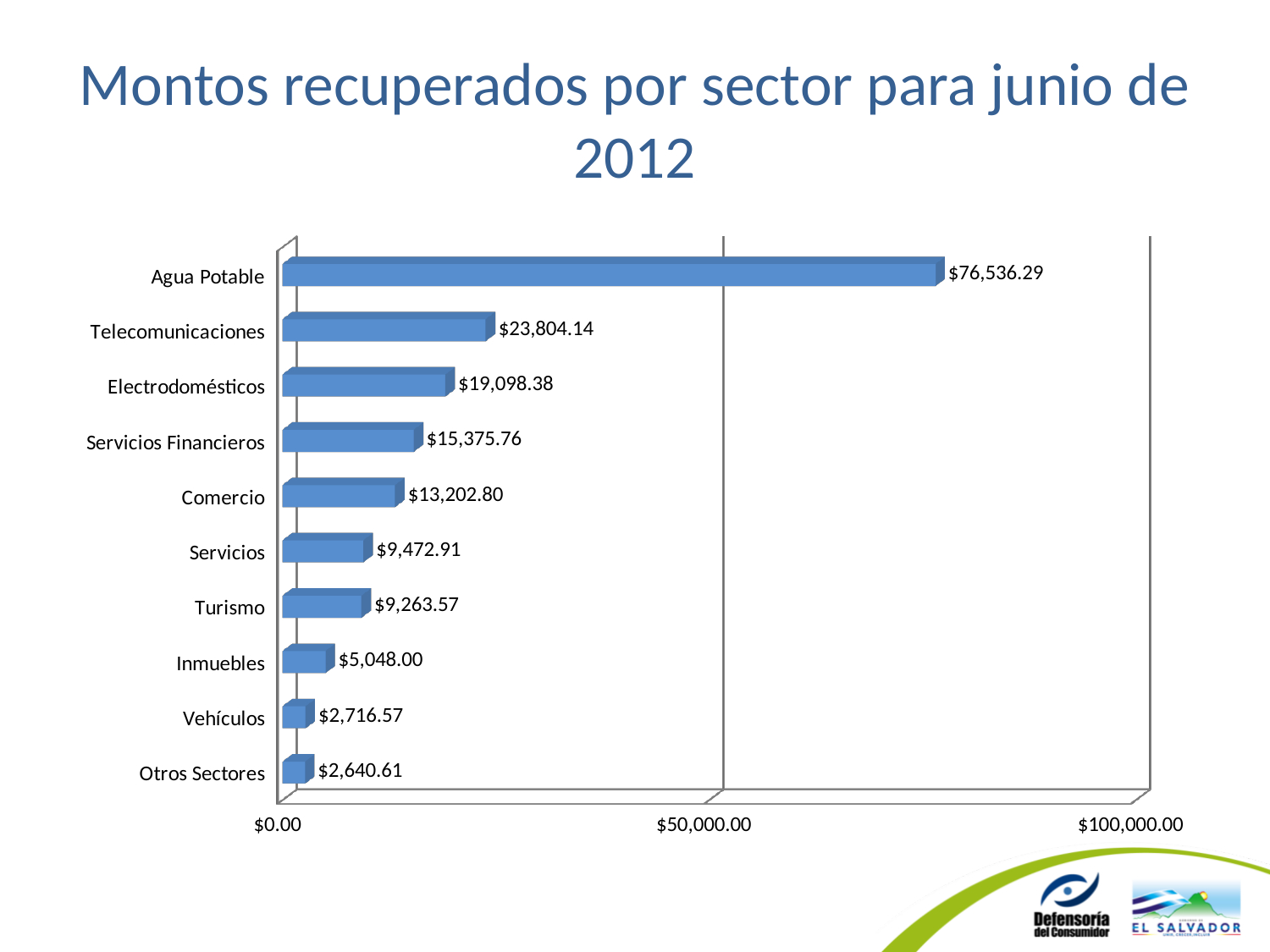
How many sectors are shown in the chart? 10 What is the value for Agua Potable? $76,536.29 What is the difference between the values for Agua Potable and Telecomunicaciones? $52,732.15 Which sector has the highest recovered amount? Agua Potable What is the value for Telecomunicaciones? $23,804.14 What is the title of the slide? Montos recuperados por sector para junio de 2012 What kind of chart is shown on the slide? bar chart Which is larger, the value for Comercio or the value for Servicios? Comercio Is the value for Agua Potable greater or less than $50,000.00? greater What is the difference between the values for Electrodomésticos and Servicios Financieros? $3,722.62 Which sector has the lowest recovered amount? Otros Sectores What is the value for Inmuebles? $5,048.00